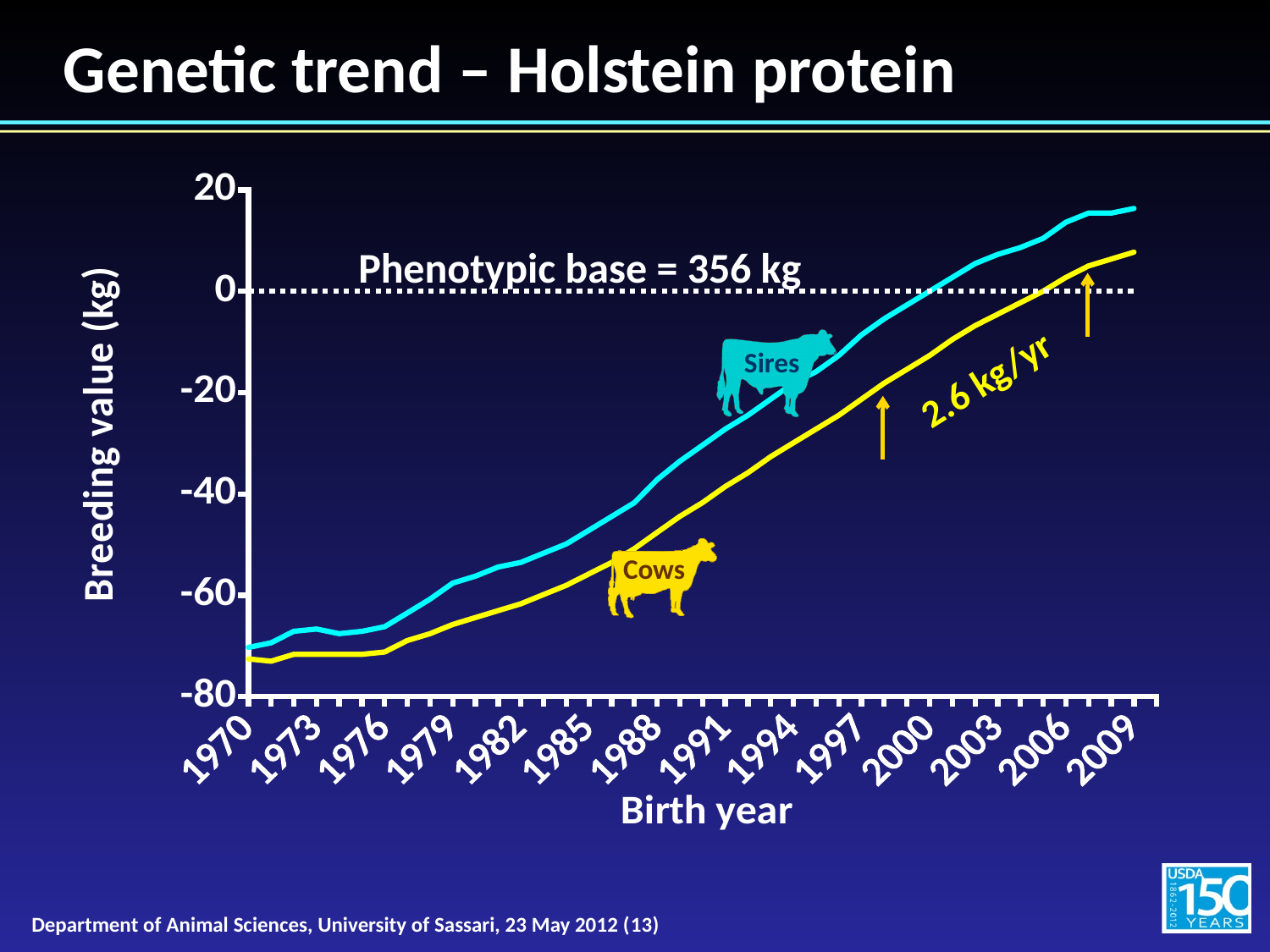
Is the Sires breeding value for 1991 greater or less than -20? less How many series are plotted on the chart? 3 Is the Cows breeding value for 1985 greater or less than -40? less What annual rate of genetic gain is annotated on the chart? 2.6 kg/yr Do the Cows breeding values rise or fall from 1970 to 2009? rise Is the Sires breeding value for 2009 greater or less than 0? greater How many birth-year labels are shown on the x axis? 14 What kind of chart is shown on the slide? line chart In 2000, which series has the higher breeding value, Sires or Cows? Sires What phenotypic base value is stated on the chart? 356 kg Do the Sires breeding values rise or fall from 1970 to 2009? rise